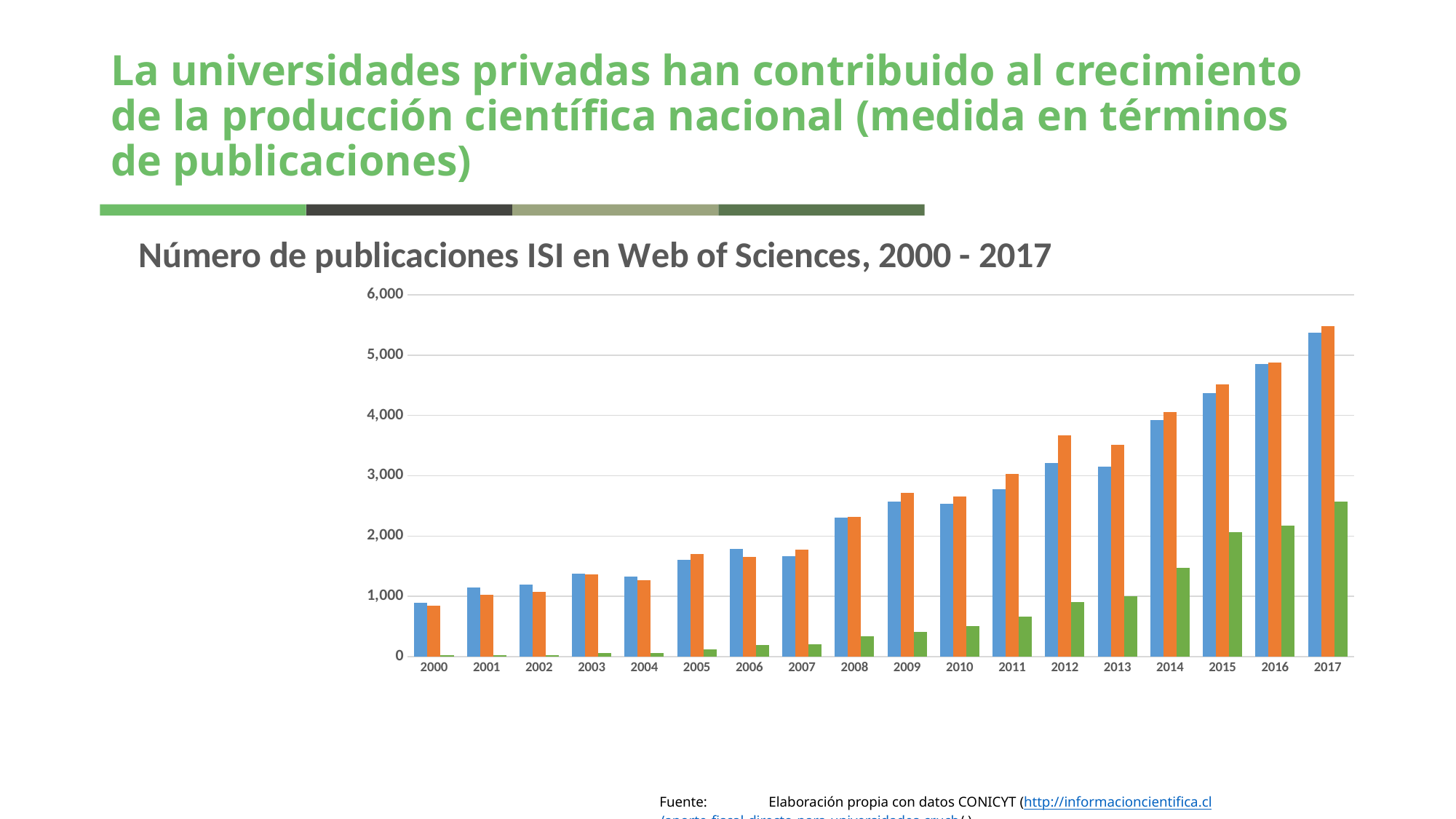
Is the value of the green bar for 2017 greater or less than 2,000? greater Is the value of the orange bar for 2012 greater or less than 3,000? greater What kind of chart is shown on the slide? bar chart Is the value of the blue bar for 2000 greater or less than 1,000? less In 2012, which is larger: the orange bar or the blue bar? orange bar What is the title of the chart? Número de publicaciones ISI en Web of Sciences, 2000 - 2017 How many years are shown on the x axis of the chart? 18 In which year is the blue series at its lowest? 2000 Do the values of the green series rise or fall from 2000 to 2017? rise How many bar series (colours) are plotted for each year in the chart? 3 In which year is the green series at its highest? 2017